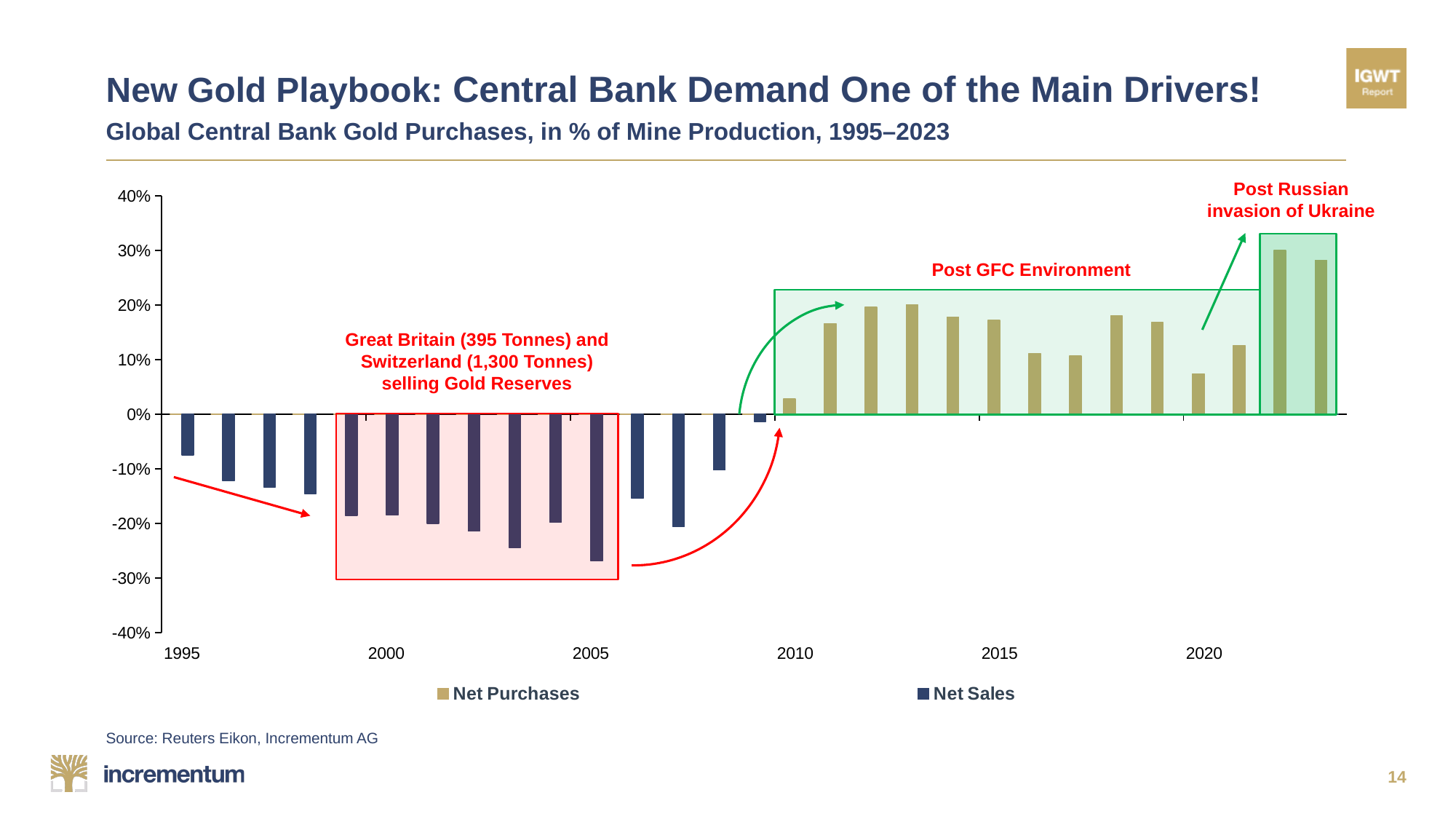
Do the values rise or fall from 1995 to 1998? fall How many series does the legend list? 2 Is the value for 2005 greater or less than -20%? less Which year shows the lowest (most negative) value in the chart? 2005 What kind of chart is shown on the slide? Bar chart Is the value for 1995 greater or less than -10%? greater What is the subtitle of the chart? Global Central Bank Gold Purchases, in % of Mine Production, 1995–2023 How many years (bars) are plotted in the chart? 29 Which year has the larger value, 2012 or 2016? 2012 Is the value for 2010 greater or less than 10%? less What are the two series named in the legend? Net Purchases and Net Sales